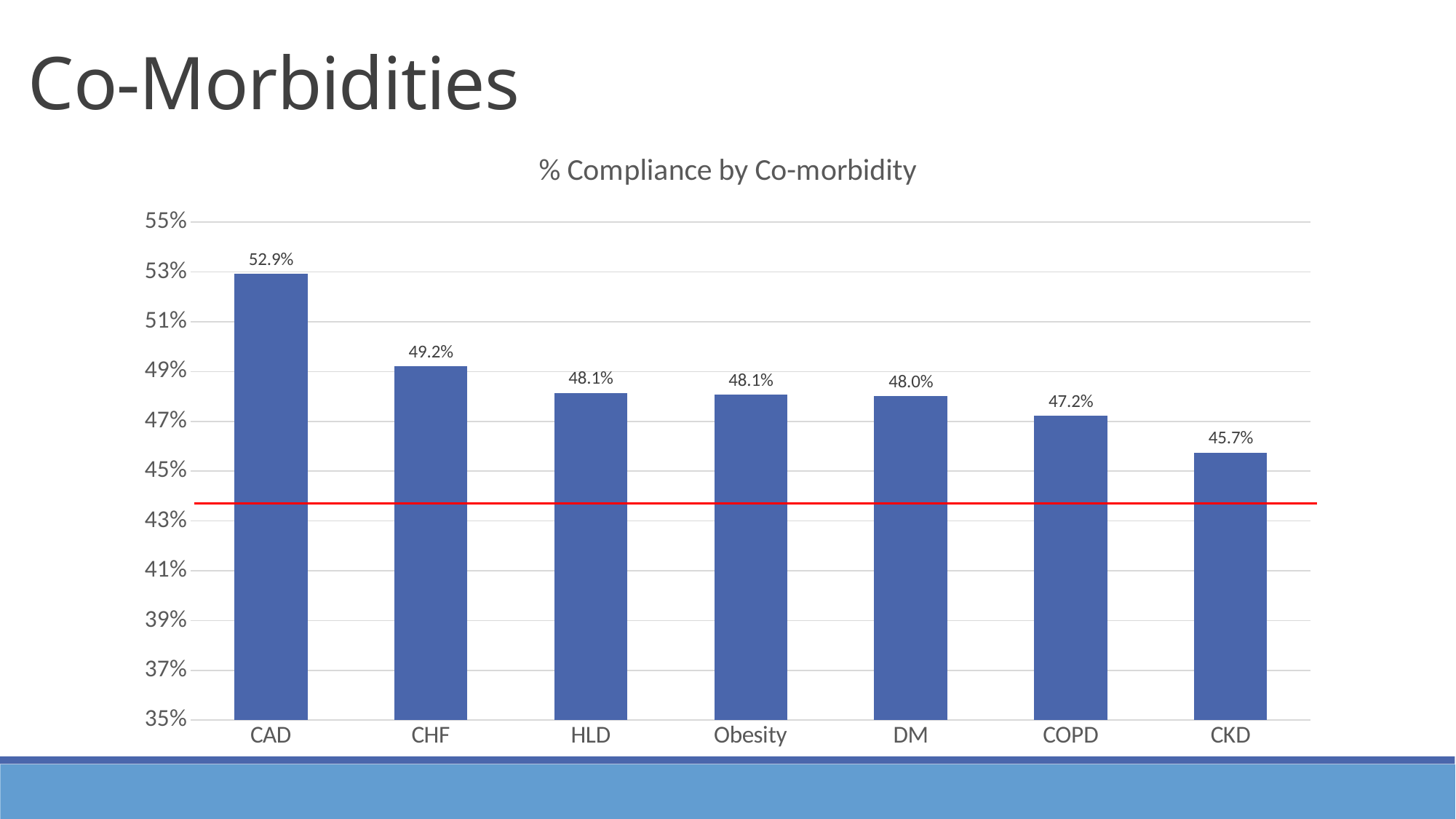
What is the title of the chart? % Compliance by Co-morbidity Which co-morbidity has the lowest % compliance? CKD What is the % compliance for COPD? 47.2% How many co-morbidity categories are shown on the chart? 7 What is the % compliance for CAD? 52.9% What is the % compliance for CKD? 45.7% What is the difference in % compliance between CHF and COPD? 2.0% Which co-morbidity has the highest % compliance? CAD What is the difference in % compliance between CAD and CKD? 7.2% What kind of chart is shown on the slide? Bar chart What is the % compliance for CHF? 49.2% Which has a higher % compliance, CHF or DM? CHF